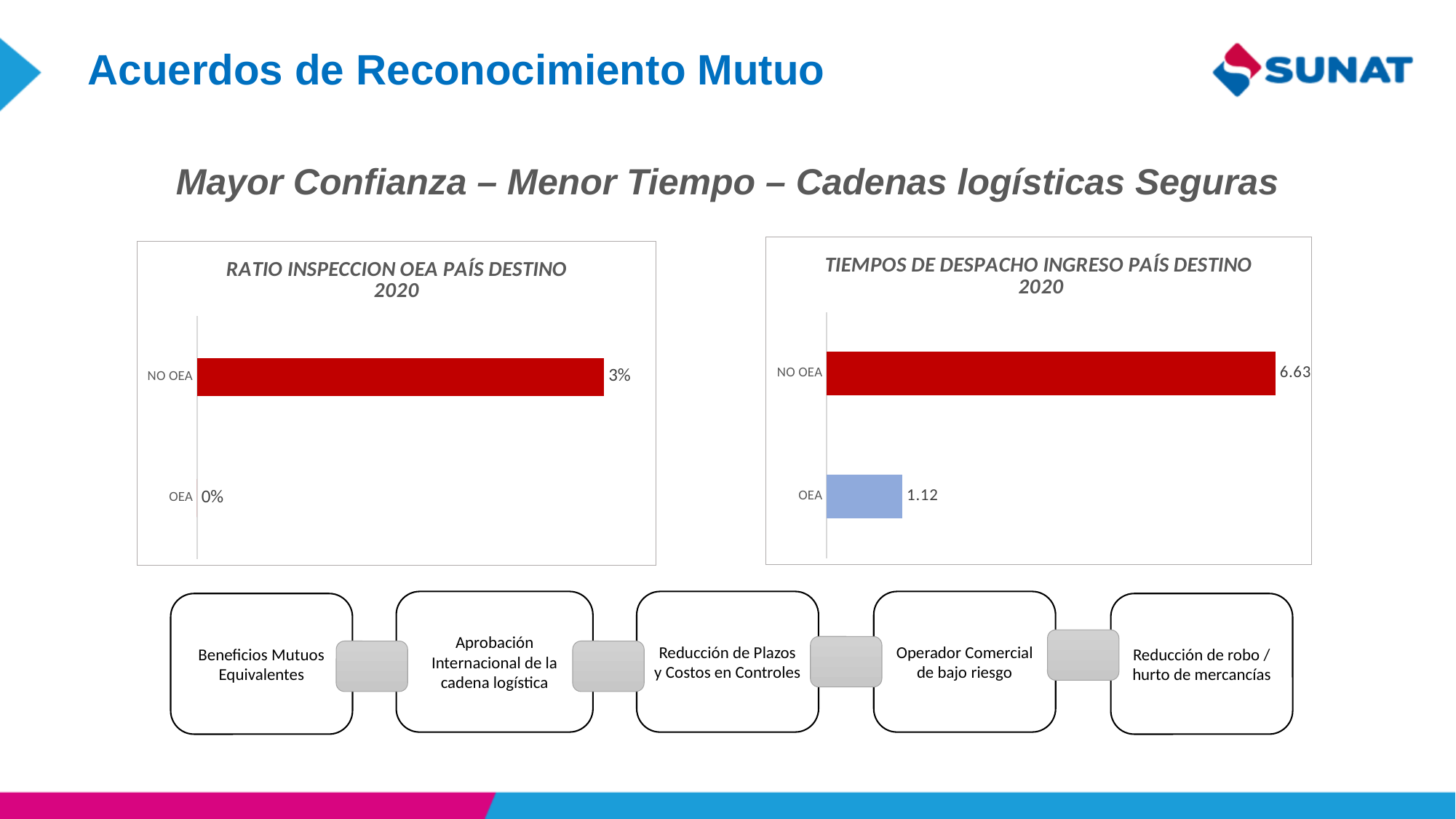
In the chart titled 'TIEMPOS DE DESPACHO INGRESO PAÍS DESTINO 2020', what is the value for OEA? 1.12 In the chart titled 'RATIO INSPECCION OEA PAÍS DESTINO 2020', what is the difference between the NO OEA and OEA values? 3% In the chart titled 'TIEMPOS DE DESPACHO INGRESO PAÍS DESTINO 2020', what is the value for NO OEA? 6.63 What kind of chart is the chart on the left of the slide, titled 'RATIO INSPECCION OEA PAÍS DESTINO 2020'? Bar chart How many categories are shown in the chart titled 'TIEMPOS DE DESPACHO INGRESO PAÍS DESTINO 2020'? 2 In the chart titled 'TIEMPOS DE DESPACHO INGRESO PAÍS DESTINO 2020', which category has the highest value? NO OEA In the chart titled 'RATIO INSPECCION OEA PAÍS DESTINO 2020', what is the value for OEA? 0% In the chart titled 'TIEMPOS DE DESPACHO INGRESO PAÍS DESTINO 2020', what colour is the OEA bar? Light blue In the chart titled 'TIEMPOS DE DESPACHO INGRESO PAÍS DESTINO 2020', which is larger, the value for OEA or the value for NO OEA? NO OEA In the chart titled 'TIEMPOS DE DESPACHO INGRESO PAÍS DESTINO 2020', what is the difference between the NO OEA and OEA values? 5.51 In the chart titled 'RATIO INSPECCION OEA PAÍS DESTINO 2020', what is the value for NO OEA? 3% In the chart titled 'RATIO INSPECCION OEA PAÍS DESTINO 2020', which category has the lowest value? OEA